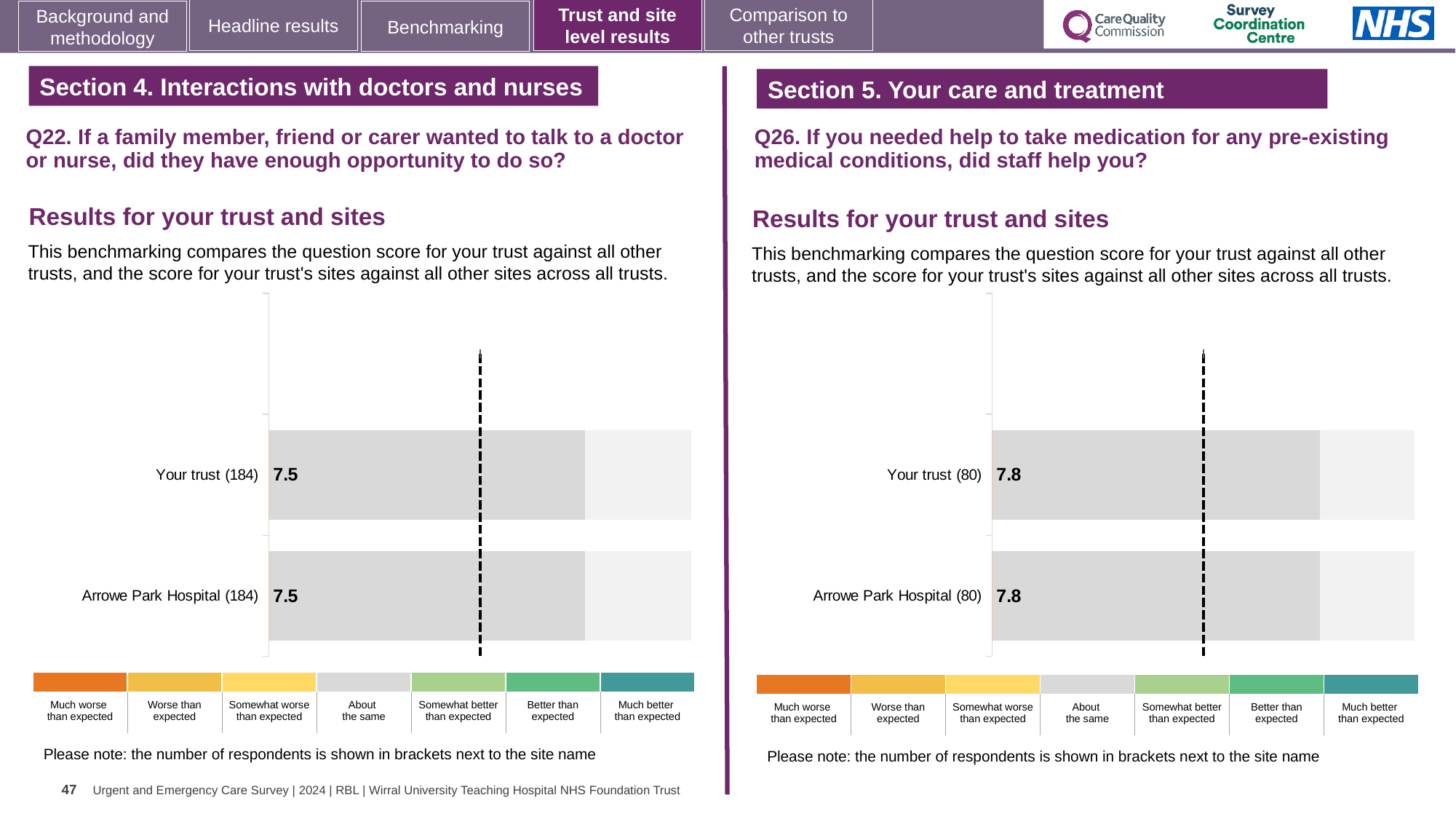
In the Q22 chart on the left, what is the score for Arrowe Park Hospital? 7.5 What kind of chart is used in the Q22 chart on the left? bar chart How many rating categories does the colour key below the Q26 chart on the right list? 7 In the Q26 chart on the right, what is the score for Your trust? 7.8 In the Q22 chart on the left, how many respondents are shown in brackets next to Arrowe Park Hospital? 184 What is the difference between the Your trust score in the Q26 chart on the right and the Your trust score in the Q22 chart on the left? 0.3 How many bars are plotted in the Q26 chart on the right? 2 How many bars are plotted in the Q22 chart on the left? 2 Which is larger: the Your trust score in the Q26 chart on the right or the Your trust score in the Q22 chart on the left? Q26 chart (7.8) Is the score for Your trust in the Q22 chart on the left larger than, smaller than, or equal to the score for Arrowe Park Hospital in the same chart? equal In the Q22 chart on the left, what is the score for Your trust? 7.5 In the Q26 chart on the right, what is the score for Arrowe Park Hospital? 7.8